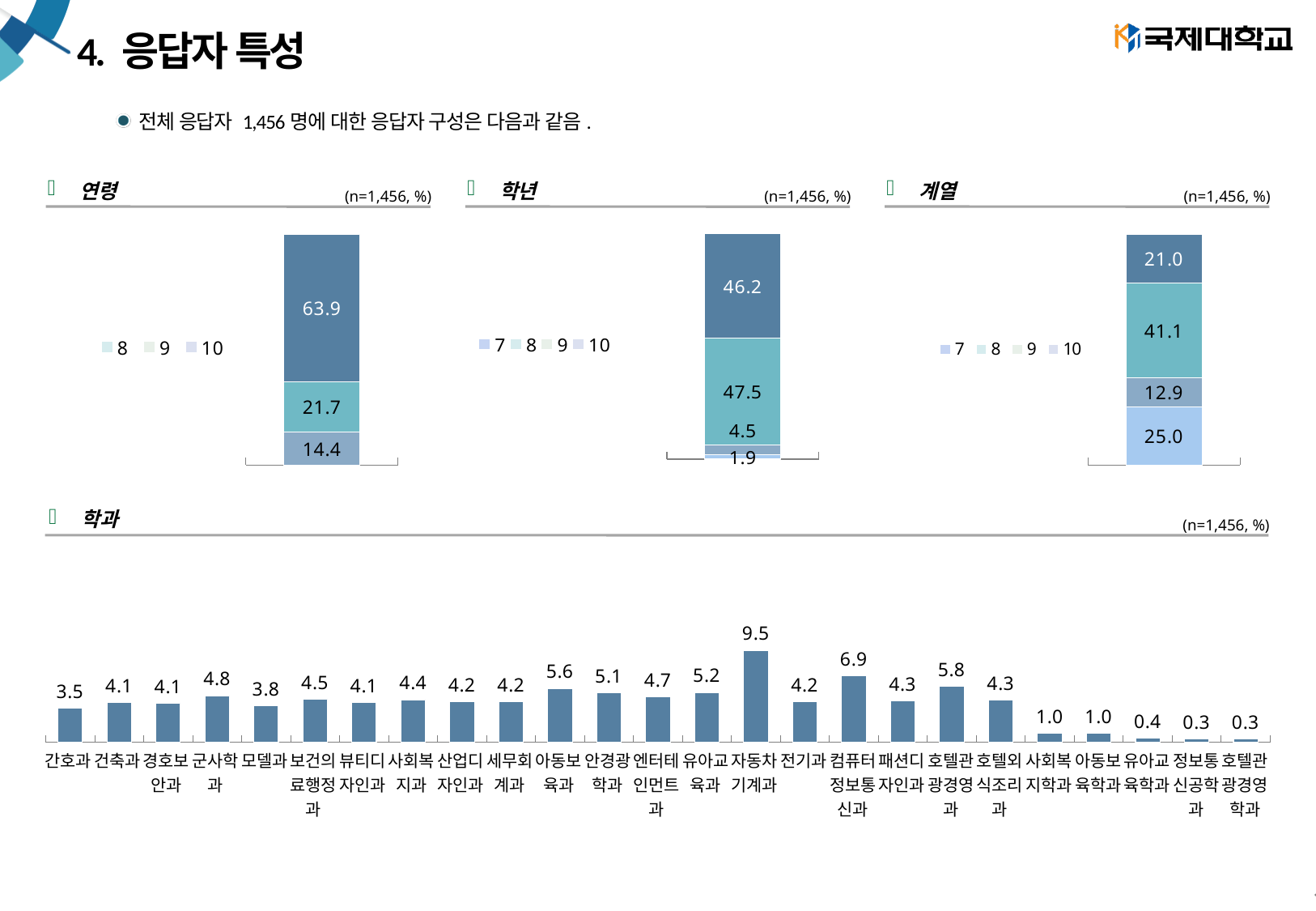
What kind of chart is the 학과 chart? bar chart In the 학년 chart, what is the value of the smallest segment of the stacked bar? 1.9 In the 학과 chart, which is larger: the value for 호텔관광경영과 or the value for 아동보육과? 호텔관광경영과 In the 학과 chart, how many departments are plotted? 25 In the 계열 chart, what is the value of the largest segment of the stacked bar? 41.1 In the 연령 chart, what is the value of the largest segment of the stacked bar? 63.9 In the 학과 chart, what is the difference between the values for 자동차기계과 and 컴퓨터정보통신과? 2.6 In the 학과 chart, which department has the highest value? 자동차기계과 In the 학과 chart, what is the value for 자동차기계과? 9.5 In the 학과 chart, what is the value for 컴퓨터정보통신과? 6.9 In the 연령 chart, what is the total of the stacked bar? 100.0 In the 계열 chart, how many segments does the stacked bar have? 4